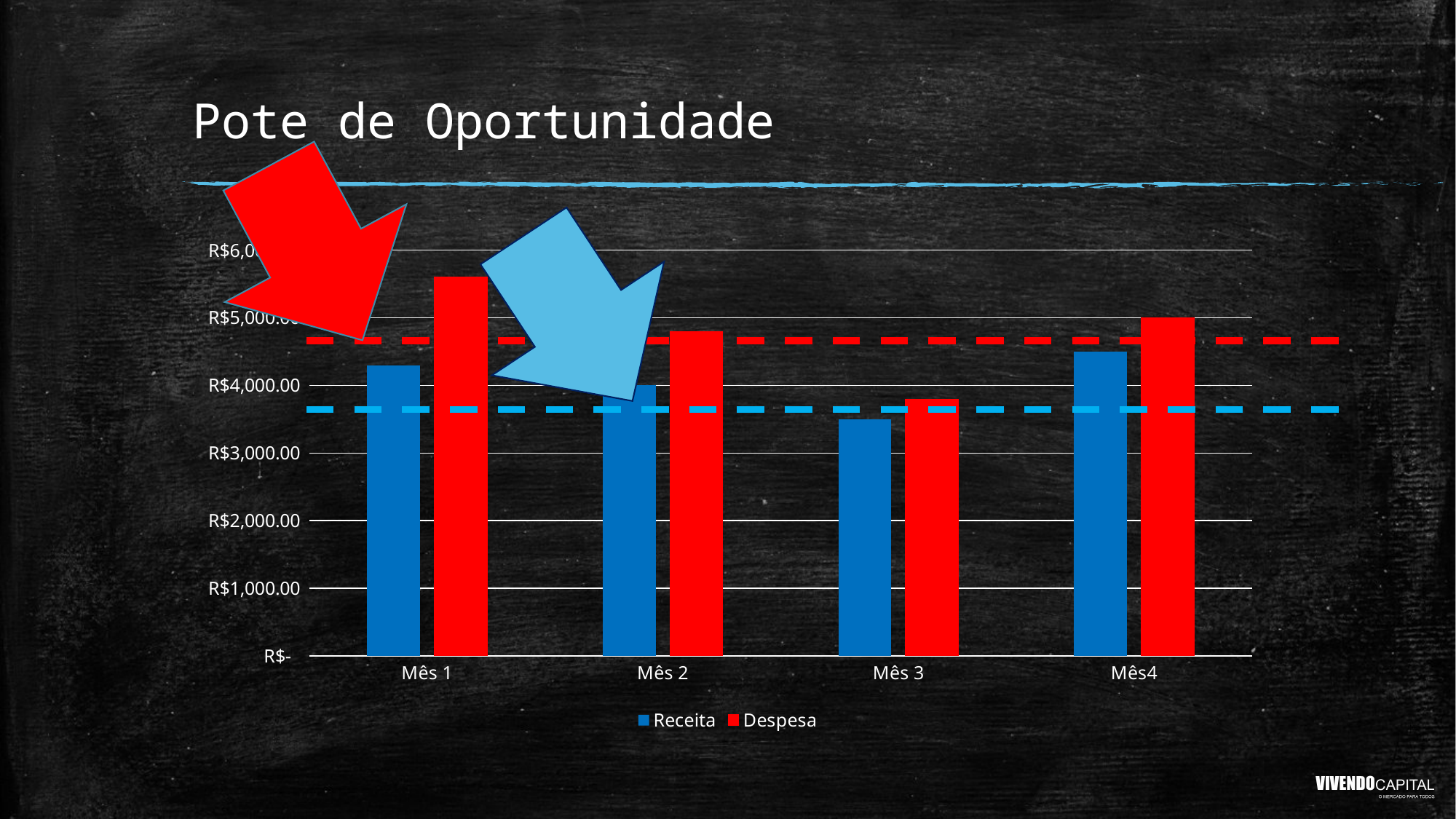
Is the Despesa value for Mês 1 greater or less than R$5,000.00? greater In Mês 1, which is larger, Receita or Despesa? Despesa What kind of chart is shown on the slide? bar chart Is the Despesa value for Mês 2 greater or less than R$5,000.00? less In which month is Despesa lowest? Mês 3 In which month is Despesa highest? Mês 1 In which month is Receita lowest? Mês 3 Is the Receita value for Mês 3 greater or less than R$4,000.00? less How many months (categories) are shown on the x axis? 4 Which series is drawn in red? Despesa What is the title of the chart on the slide? Pote de Oportunidade How many series does the chart's legend list? 2